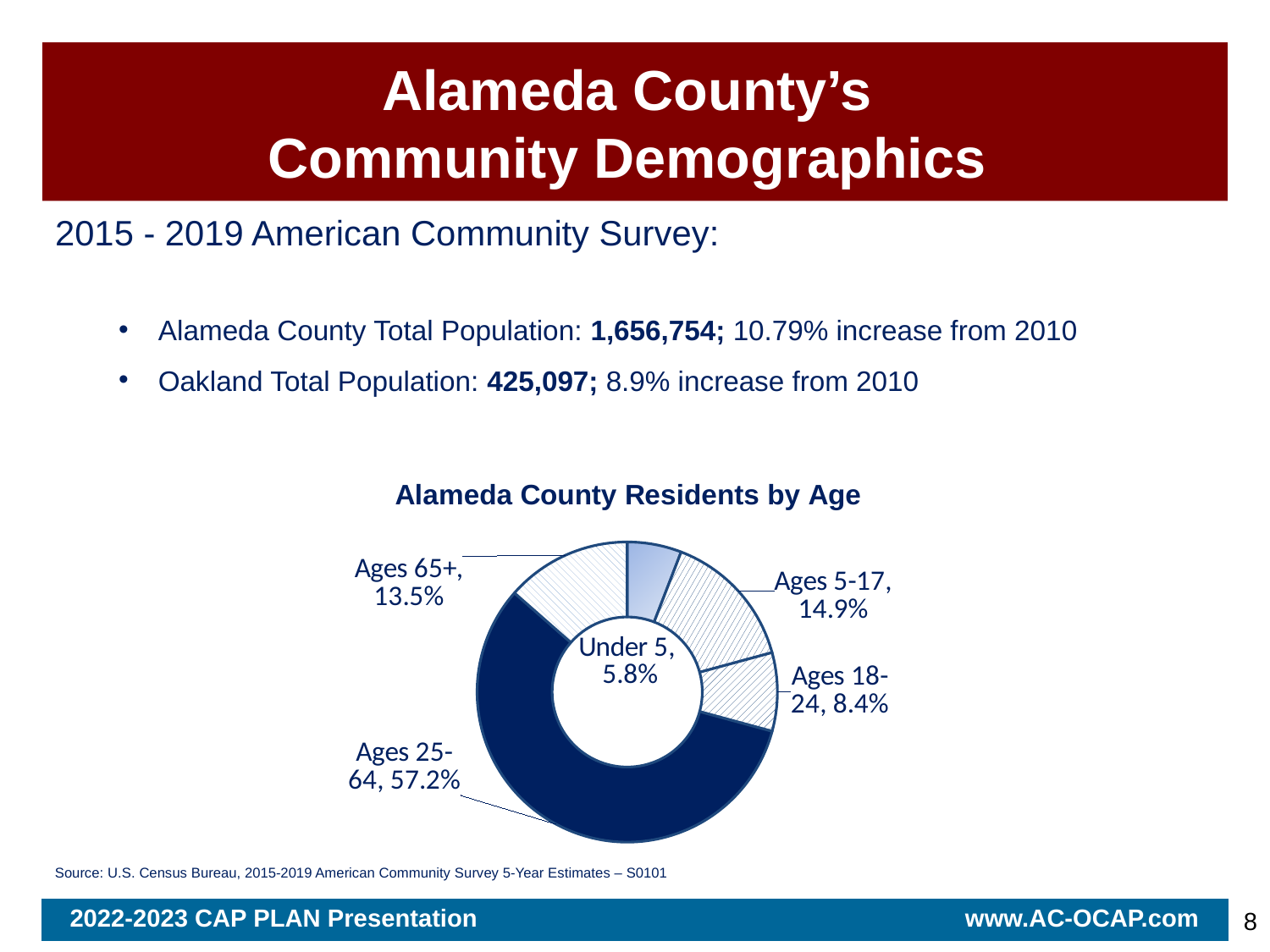
What share of Alameda County residents are Ages 25-64? 57.2% What share of Alameda County residents are Ages 65+? 13.5% Which age group has the largest share of Alameda County residents? Ages 25-64 What share of Alameda County residents are Ages 18-24? 8.4% What share of Alameda County residents are Under 5? 5.8% Which age group has the smallest share of Alameda County residents? Under 5 What kind of chart is used to show Alameda County residents by age? Doughnut (pie) chart How many age groups are shown in the chart? 5 What is the combined share of residents Under 5 and Ages 5-17? 20.7% What is the difference in percentage points between the Ages 5-17 share and the Ages 18-24 share? 6.5 Which is larger, the share for Ages 65+ or the share for Ages 5-17? Ages 5-17 What is the title of the chart? Alameda County Residents by Age